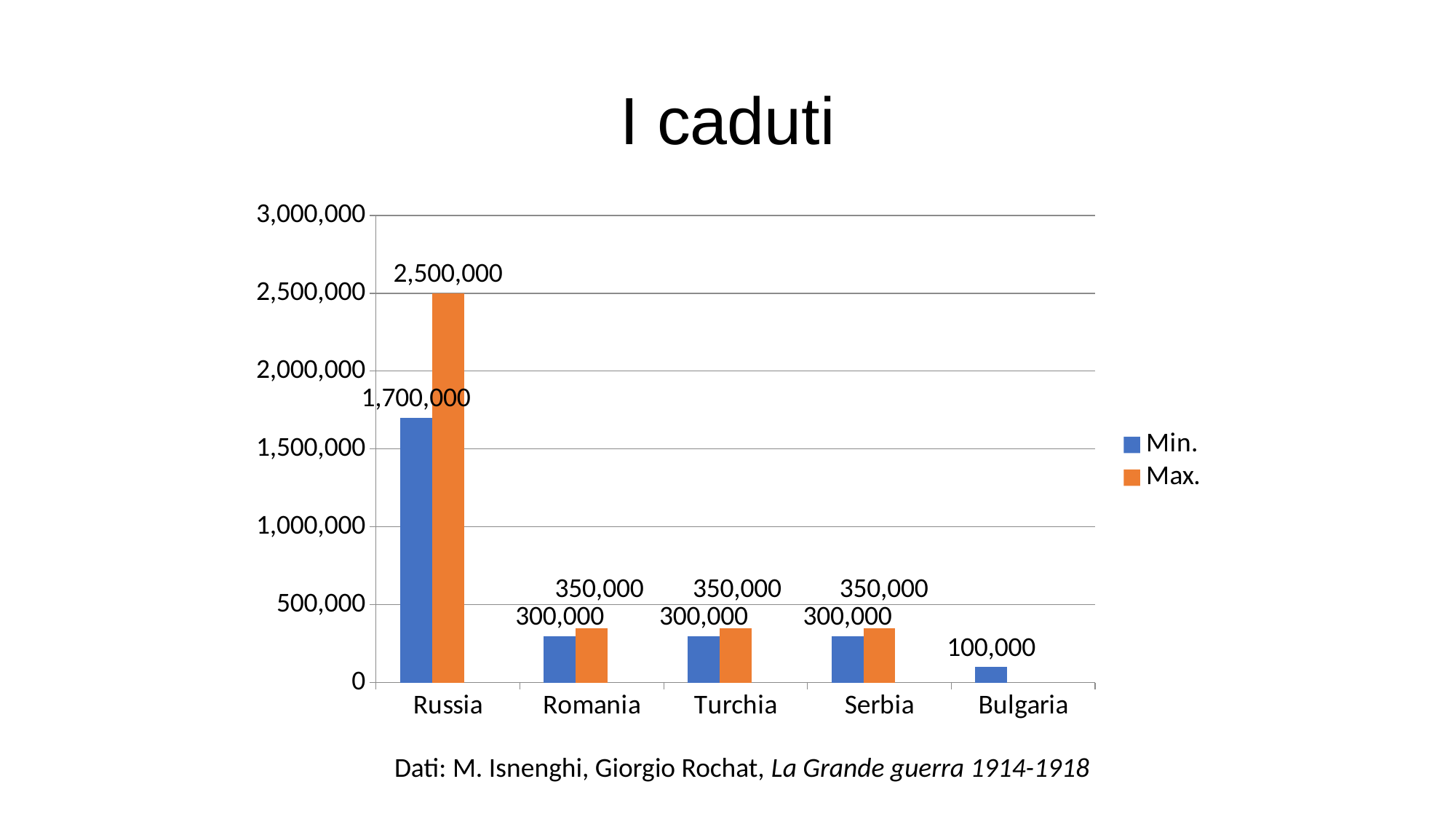
How many countries are shown on the x axis? 5 What is the Min. value for Bulgaria? 100,000 Which is larger, the Min. value for Russia or the Max. value for Turchia? Min. value for Russia What is the Min. value for Russia? 1,700,000 What is the difference between the Max. and Min. values for Russia? 800,000 What is the difference between the Min. values for Romania and Bulgaria? 200,000 What is the Max. value for Serbia? 350,000 Which country has the highest Max. value? Russia How many series does the legend list? 2 What is the Max. value for Russia? 2,500,000 Which country has the lowest Min. value? Bulgaria What kind of chart is shown on the slide? Bar chart